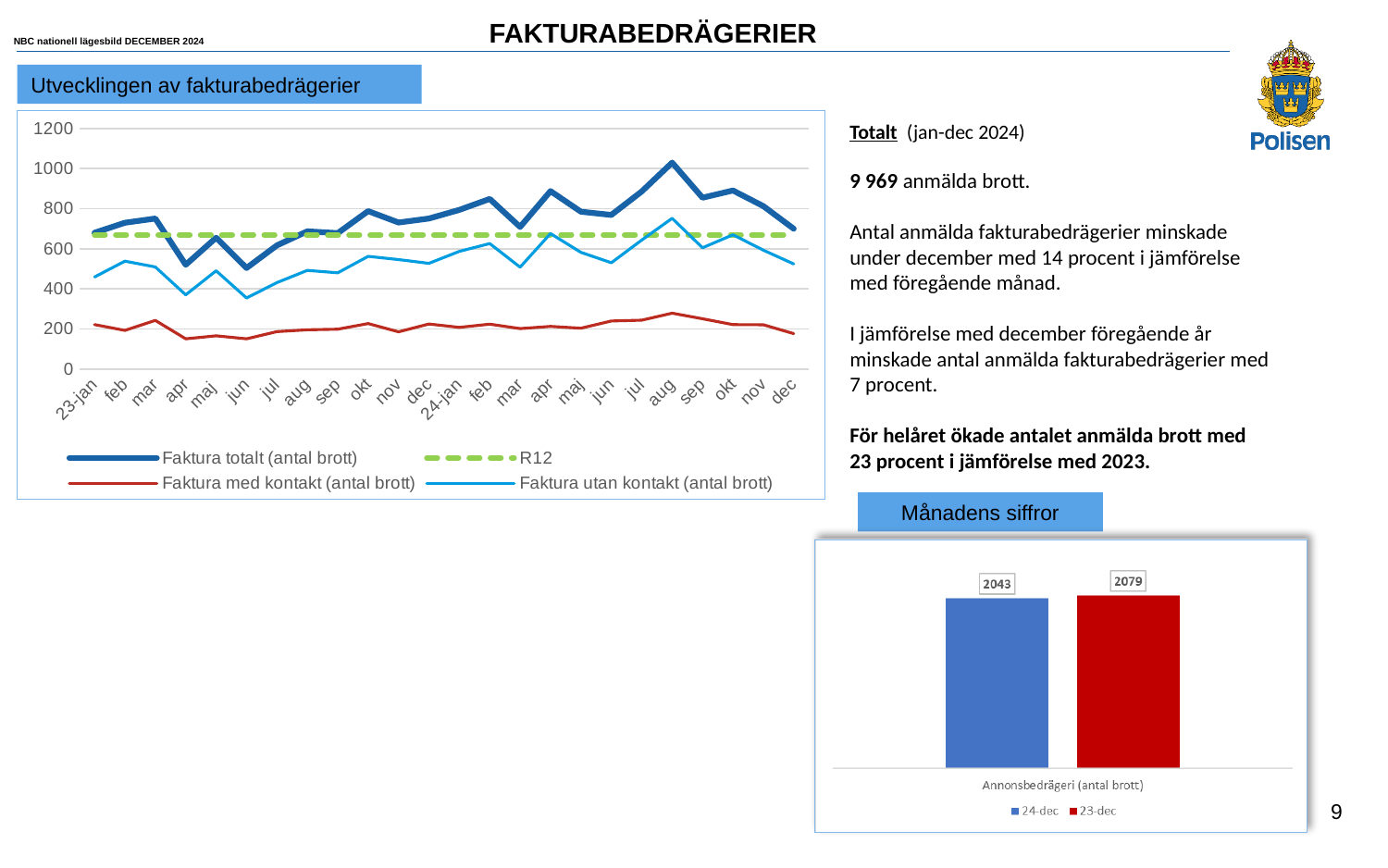
In the 'Utvecklingen av fakturabedrägerier' chart, is the value of 'Faktura totalt (antal brott)' in aug 2024 greater or less than 800? greater In the 'Månadens siffror' bar chart, what is the value for 24-dec? 2043 In the 'Månadens siffror' chart, how many series does the legend list? 2 In the 'Utvecklingen av fakturabedrägerier' chart, how many series does the legend list? 4 What kind of chart is the 'Månadens siffror' chart? Bar chart In the 'Utvecklingen av fakturabedrägerier' chart, in which month does 'Faktura totalt (antal brott)' reach its highest value? aug (2024) In the 'Månadens siffror' bar chart, what is the value for 23-dec? 2079 In the 'Utvecklingen av fakturabedrägerier' chart, how many months are shown on the x axis? 24 In the 'Månadens siffror' bar chart, which bar is higher, 24-dec or 23-dec? 23-dec In the 'Månadens siffror' bar chart, what is the category label on the x axis? Annonsbedrägeri (antal brott) What kind of chart is the 'Utvecklingen av fakturabedrägerier' chart? Line chart In the 'Månadens siffror' bar chart, what is the difference between the 23-dec and 24-dec values? 36